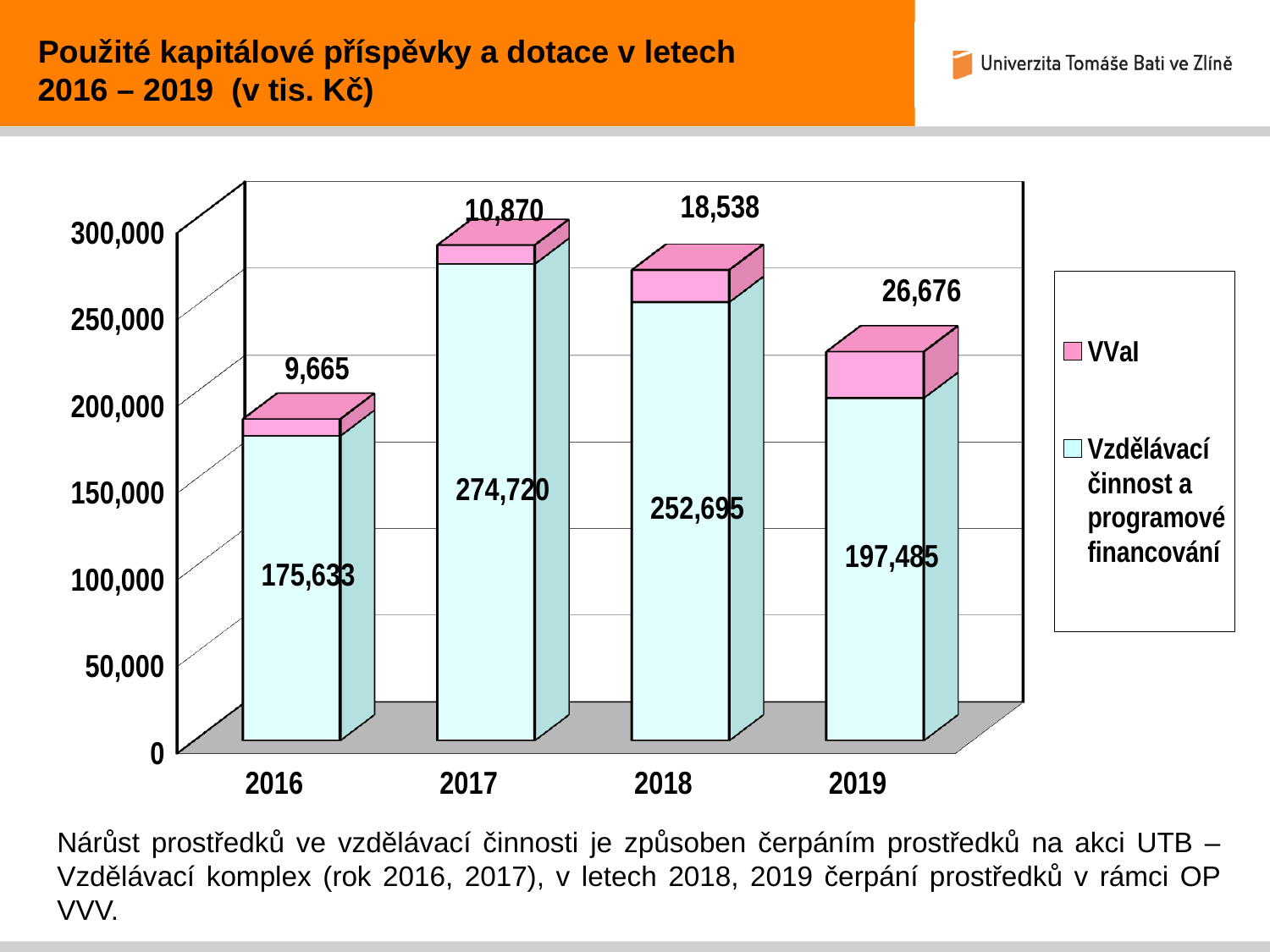
Which year has the highest VVaI value? 2019 Which year has the lowest value for Vzdělávací činnost a programové financování? 2016 What is the total of the stacked bar for 2017? 285,590 What is the difference between the VVaI values for 2019 and 2016? 17,011 Which is larger, the Vzdělávací činnost a programové financování value for 2018 or for 2019? 2018 What is the value for Vzdělávací činnost a programové financování in 2016? 175,633 What is the total of the stacked bar for 2019? 224,161 How many series does the legend list? 2 How many years are shown on the x axis? 4 What is the value for Vzdělávací činnost a programové financování in 2017? 274,720 What kind of chart is shown on the slide? Stacked bar chart What is the VVaI value for 2019? 26,676